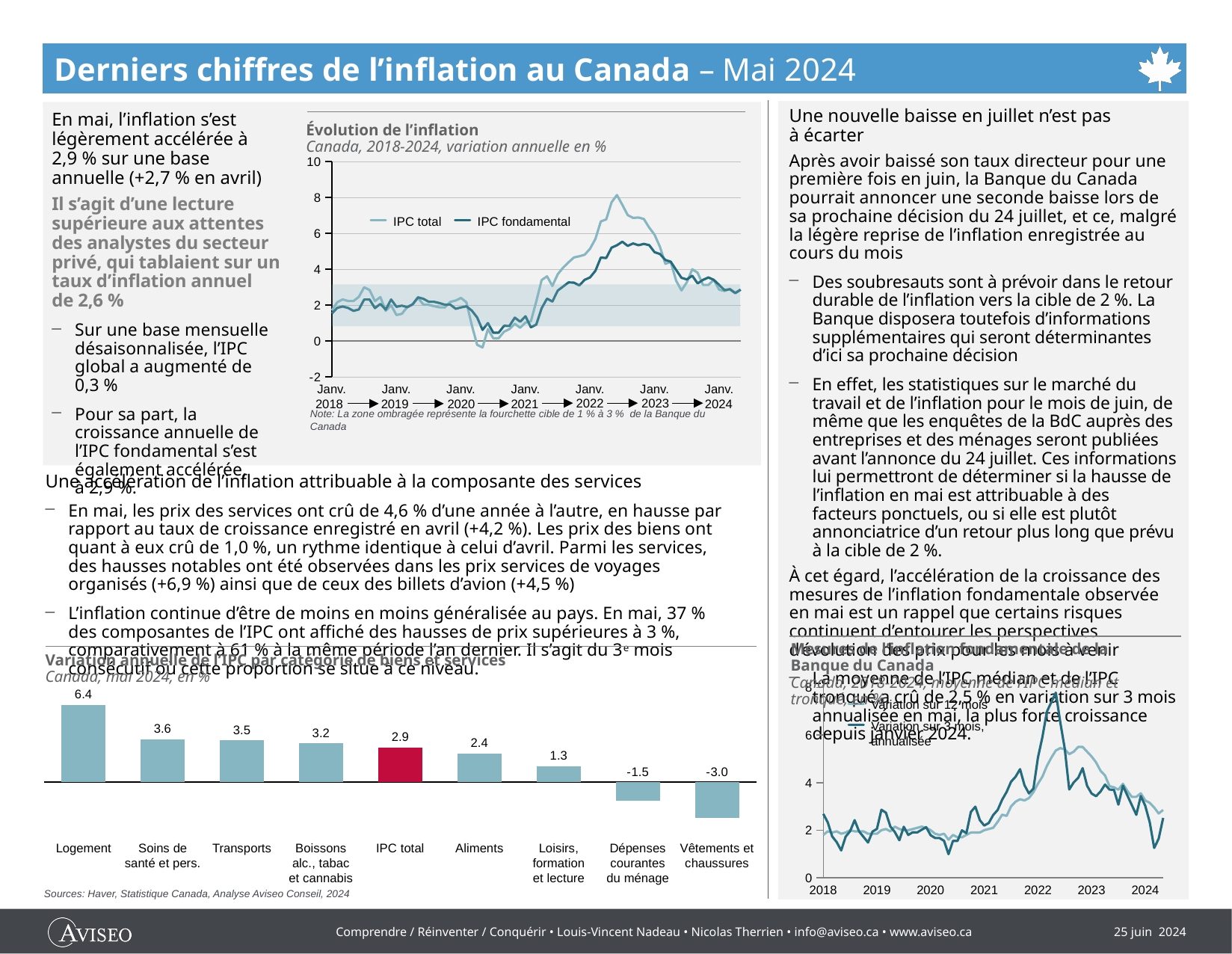
In the chart 'Variation annuelle de l'IPC par catégorie de biens et services', what is the value for IPC total? 2.9 In the chart 'Variation annuelle de l'IPC par catégorie de biens et services', what is the value for Logement? 6.4 In the chart 'Variation annuelle de l'IPC par catégorie de biens et services', which category has the highest value? Logement What kind of chart is 'Variation annuelle de l'IPC par catégorie de biens et services'? Bar chart In the chart 'Variation annuelle de l'IPC par catégorie de biens et services', what is the difference between the values for Logement and Aliments? 4.0 What kind of chart is 'Évolution de l'inflation'? Line chart In the chart 'Variation annuelle de l'IPC par catégorie de biens et services', what is the value for Vêtements et chaussures? -3.0 How many series does the legend of the chart 'Évolution de l'inflation' list? 2 In the chart 'Variation annuelle de l'IPC par catégorie de biens et services', which is larger, the value for Transports or the value for Loisirs, formation et lecture? Transports In the chart 'Variation annuelle de l'IPC par catégorie de biens et services', which category has the lowest value? Vêtements et chaussures How many categories are shown in the chart 'Variation annuelle de l'IPC par catégorie de biens et services'? 9 In the chart 'Évolution de l'inflation', is the peak value of IPC total in 2022 greater or less than 6? greater